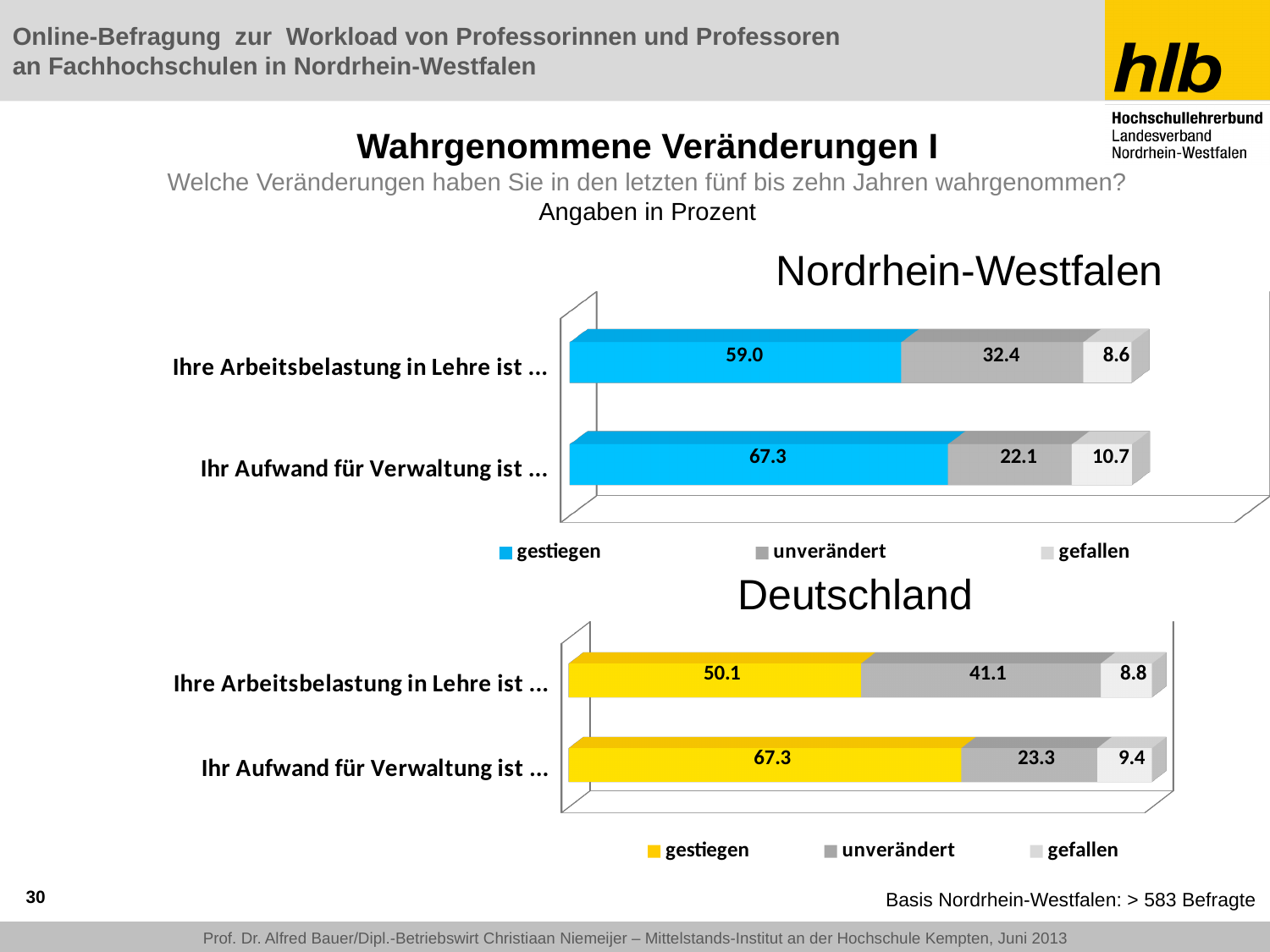
What kind of chart is the Nordrhein-Westfalen chart? Stacked bar chart In the Deutschland chart, what is the total of the stacked bar for "Ihr Aufwand für Verwaltung ist ..."? 100.0 In the Nordrhein-Westfalen chart, what is the value for "gestiegen" for "Ihre Arbeitsbelastung in Lehre ist ..."? 59.0 In the Nordrhein-Westfalen chart, which category has the higher "unverändert" value? Ihre Arbeitsbelastung in Lehre ist ... In the Deutschland chart, what is the value for "gestiegen" for "Ihr Aufwand für Verwaltung ist ..."? 67.3 How many categories are shown in the Nordrhein-Westfalen chart? 2 How many series does the legend of the Deutschland chart list? 3 In the Deutschland chart, what is the difference between the "unverändert" values for "Ihre Arbeitsbelastung in Lehre ist ..." and "Ihr Aufwand für Verwaltung ist ..."? 17.8 In the Deutschland chart, which category has the lower "gestiegen" value? Ihre Arbeitsbelastung in Lehre ist ... In the Nordrhein-Westfalen chart, what is the value for "gefallen" for "Ihr Aufwand für Verwaltung ist ..."? 10.7 In the Deutschland chart, what is the value for "unverändert" for "Ihre Arbeitsbelastung in Lehre ist ..."? 41.1 In the Nordrhein-Westfalen chart, what is the difference between the "gestiegen" values for "Ihr Aufwand für Verwaltung ist ..." and "Ihre Arbeitsbelastung in Lehre ist ..."? 8.3